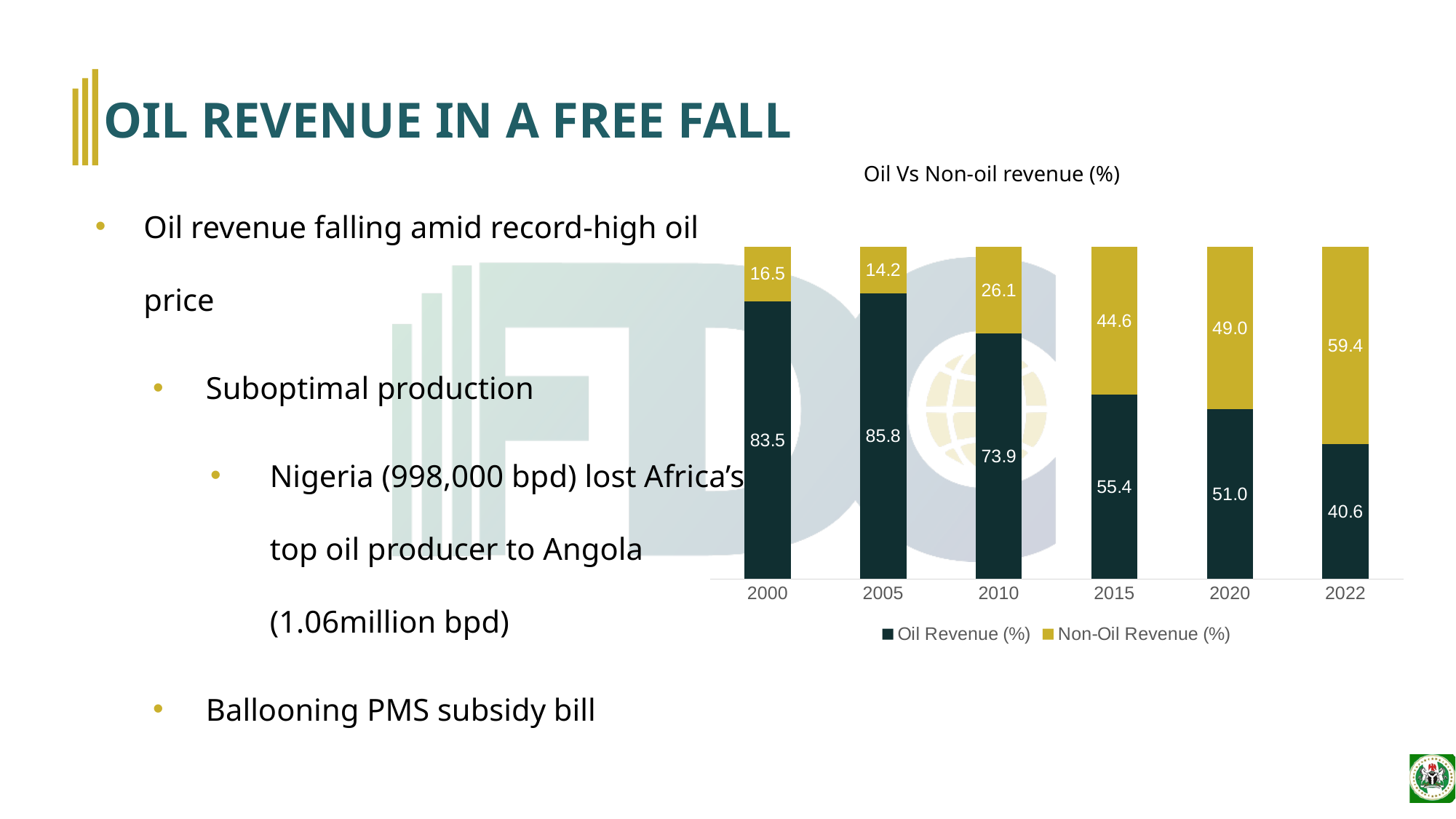
What is the title of the chart? Oil Vs Non-oil revenue (%) Which year has the lowest Non-Oil Revenue (%)? 2005 What is the Non-Oil Revenue (%) value for 2022? 59.4 What kind of chart is shown on the slide? Stacked bar chart Does the Oil Revenue (%) rise or fall from 2005 to 2022? Fall What is the Non-Oil Revenue (%) value for 2010? 26.1 Which is larger in 2020: Oil Revenue (%) or Non-Oil Revenue (%)? Oil Revenue (%) What is the difference between the Oil Revenue (%) in 2000 and in 2022? 42.9 What is the Oil Revenue (%) value for 2000? 83.5 Which year has the highest Oil Revenue (%)? 2005 How many years are shown on the x axis of the chart? 6 How many series does the chart legend list? 2